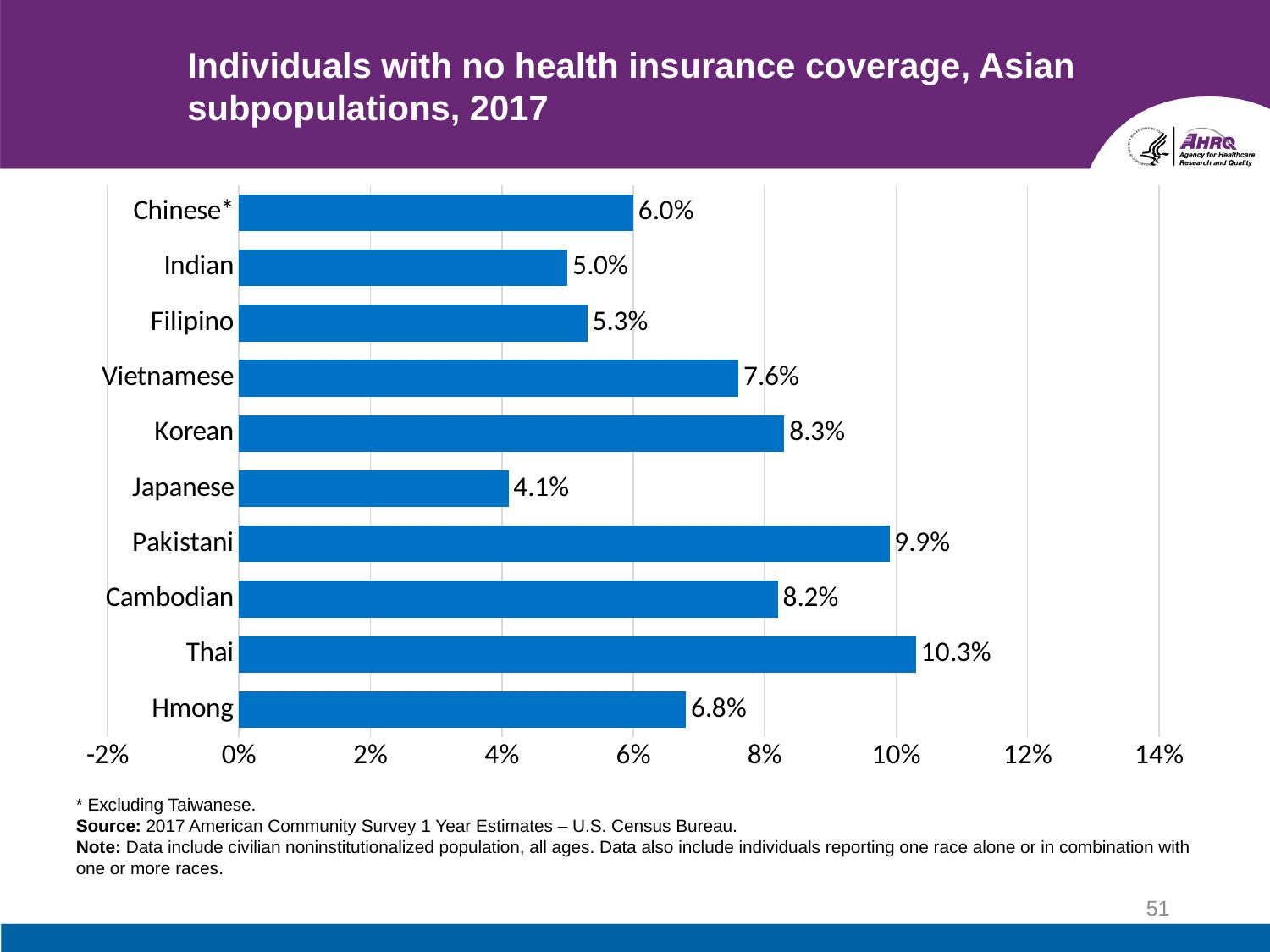
What percentage of Thai individuals had no health insurance coverage in 2017? 10.3% Which is larger, the value for Korean or the value for Filipino? Korean Is the value for Cambodian greater or less than 6%? greater What is the value shown for Japanese individuals? 4.1% What is the title of the chart? Individuals with no health insurance coverage, Asian subpopulations, 2017 What is the difference between the values for Pakistani and Indian individuals? 4.9% What is the difference between the values for Hmong and Chinese* individuals? 0.8% Which Asian subpopulation has the highest percentage with no health insurance coverage? Thai What type of chart is shown on the slide? Bar chart What is the value shown for Vietnamese individuals? 7.6% How many Asian subpopulations are shown in the chart? 10 Which Asian subpopulation has the lowest percentage with no health insurance coverage? Japanese